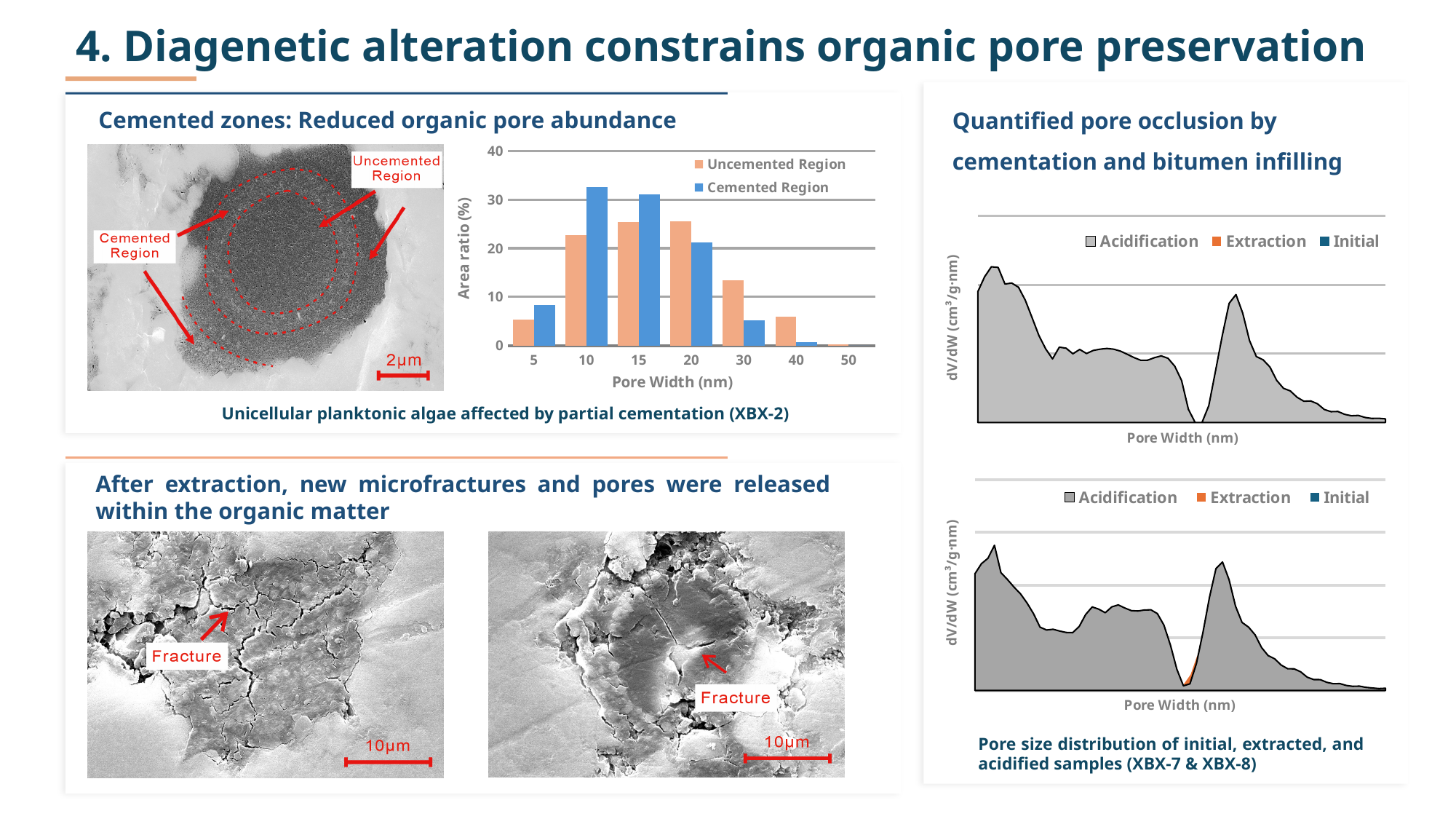
In the bar chart of area ratio versus pore width, how many series does the legend list? 2 In the bar chart of area ratio versus pore width, which series has the larger value at pore width 10? Cemented Region In the lower area chart on the right side of the slide, what is the label of the x axis? Pore Width (nm) In the upper area chart on the right side of the slide, how many series does the legend list? 3 In the bar chart of area ratio versus pore width, is the Cemented Region value at pore width 10 greater or less than 30? greater In the bar chart of area ratio versus pore width, what is the label of the y axis? Area ratio (%) In the bar chart of area ratio versus pore width, at which pore width is the Cemented Region value highest? 10 In the bar chart of area ratio versus pore width, is the Uncemented Region value at pore width 30 greater or less than 10? greater In the bar chart of area ratio versus pore width, which series has the larger value at pore width 20? Uncemented Region In the bar chart titled 'Cemented zones: Reduced organic pore abundance', what kind of chart is it? bar chart In the bar chart of area ratio versus pore width, is the Cemented Region value at pore width 30 greater or less than 10? less In the bar chart of area ratio versus pore width, how many pore width categories are shown on the x axis? 7